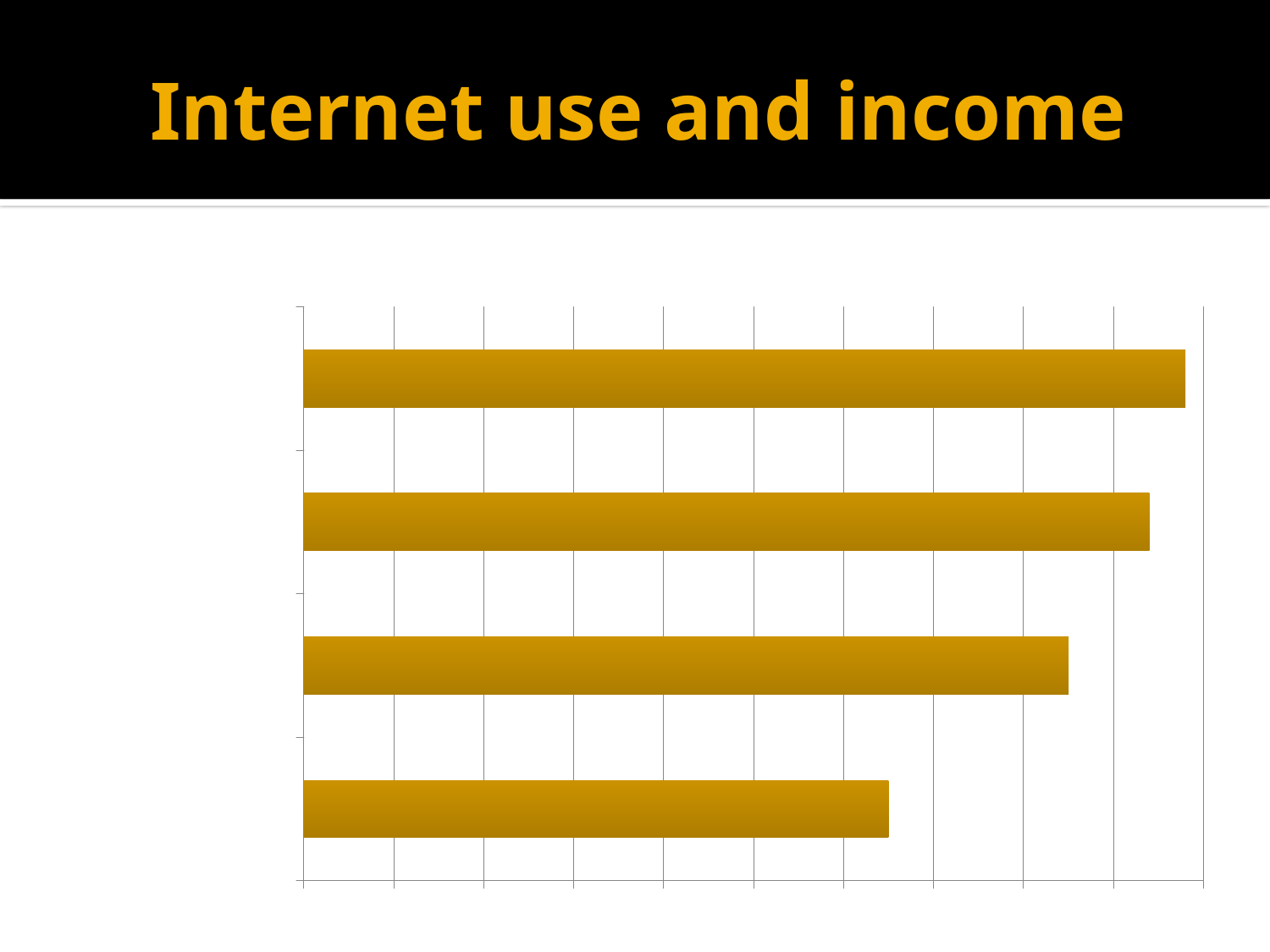
What kind of chart is shown on the slide? bar chart Which bar is the longest: the top, second, third, or bottom bar? top bar Is the bottom bar longer or shorter than the top bar? shorter Do the bar lengths increase or decrease going from the top bar to the bottom bar? decrease What colour are the bars in the chart? gold What is the title shown on the slide above the chart? Internet use and income How many bars does the chart contain? 4 Is the second bar from the top longer or shorter than the third bar from the top? longer Which bar is the shortest: the top, second, third, or bottom bar? bottom bar